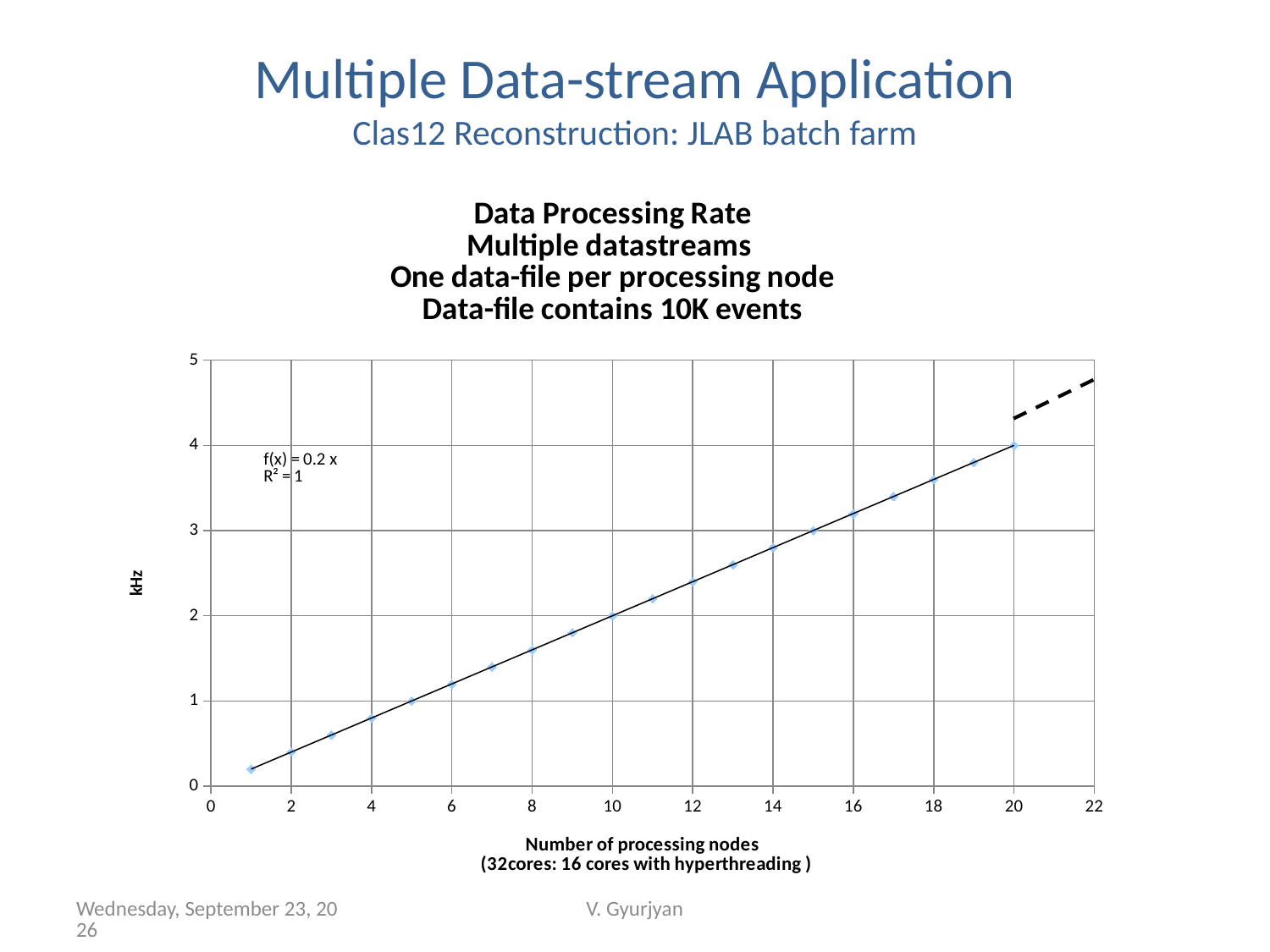
What is the title of the chart? Data Processing Rate Multiple datastreams One data-file per processing node Data-file contains 10K events Does the data processing rate rise or fall as the number of processing nodes increases? rises What is the data processing rate (kHz) for 5 processing nodes? 1 What is the data processing rate (kHz) for 15 processing nodes? 3 What kind of chart is shown on the slide? scatter chart with a linear trendline What is the data processing rate (kHz) for 10 processing nodes? 2 What is the label of the y axis? kHz What is the data processing rate (kHz) for 20 processing nodes? 4 Is the value for 8 processing nodes greater or less than 2 kHz? less How many data points are plotted on the chart? 20 Is the value for 12 processing nodes greater or less than 2 kHz? greater What is the difference in kHz between the rate at 20 nodes and the rate at 10 nodes? 2